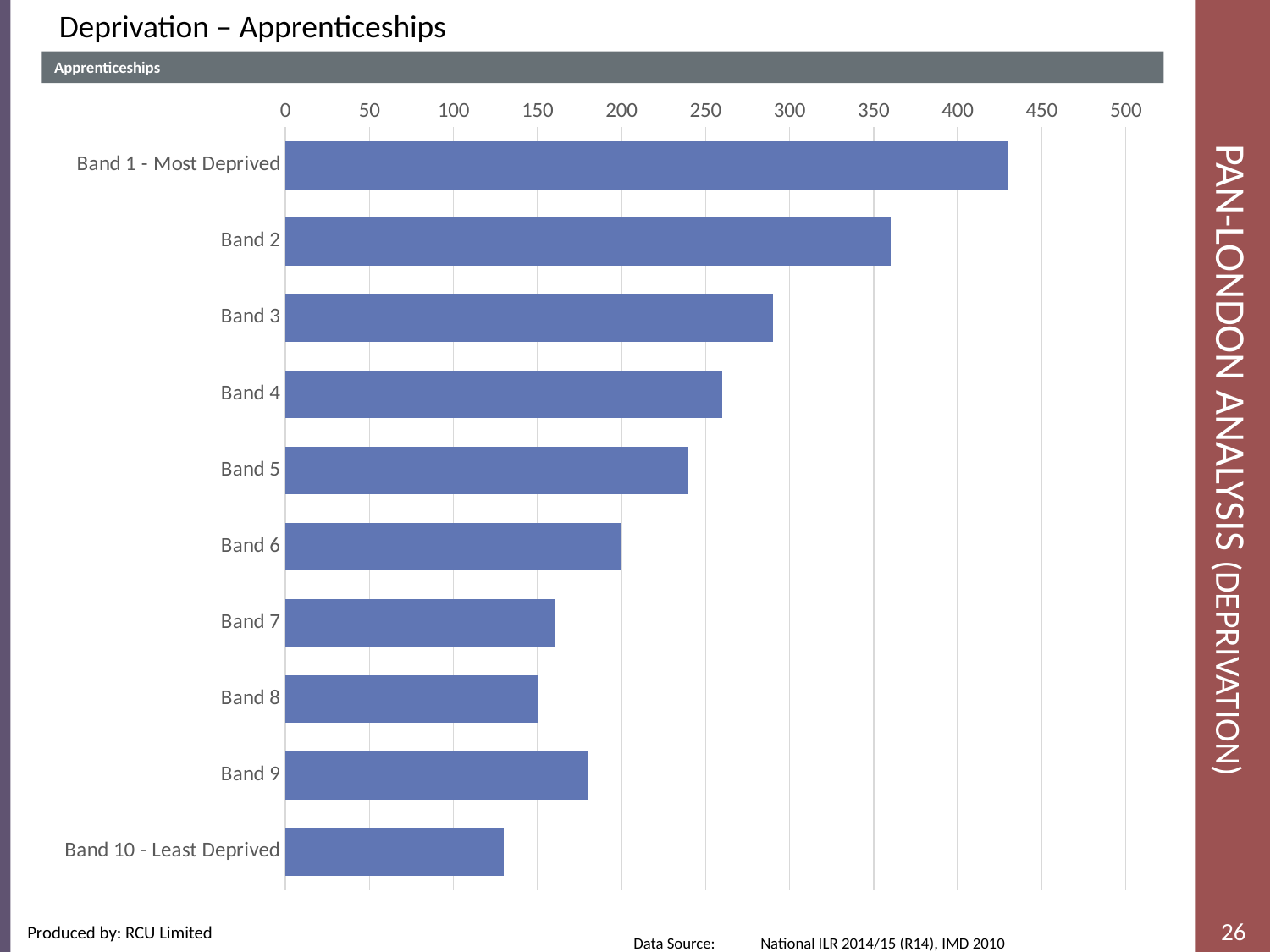
Is the value for Band 1 - Most Deprived greater or less than 400? greater Is the value for Band 5 greater or less than 250? less Which band has the lowest value in the chart? Band 10 - Least Deprived What is the title shown in the header bar above the chart? Apprenticeships Which band has the highest value in the chart? Band 1 - Most Deprived How many bands (categories) are plotted in the chart? 10 Is the value for Band 7 greater or less than 150? greater What kind of chart is shown on the slide? bar chart Which has the larger value, Band 8 or Band 9? Band 9 Which has the larger value, Band 3 or Band 4? Band 3